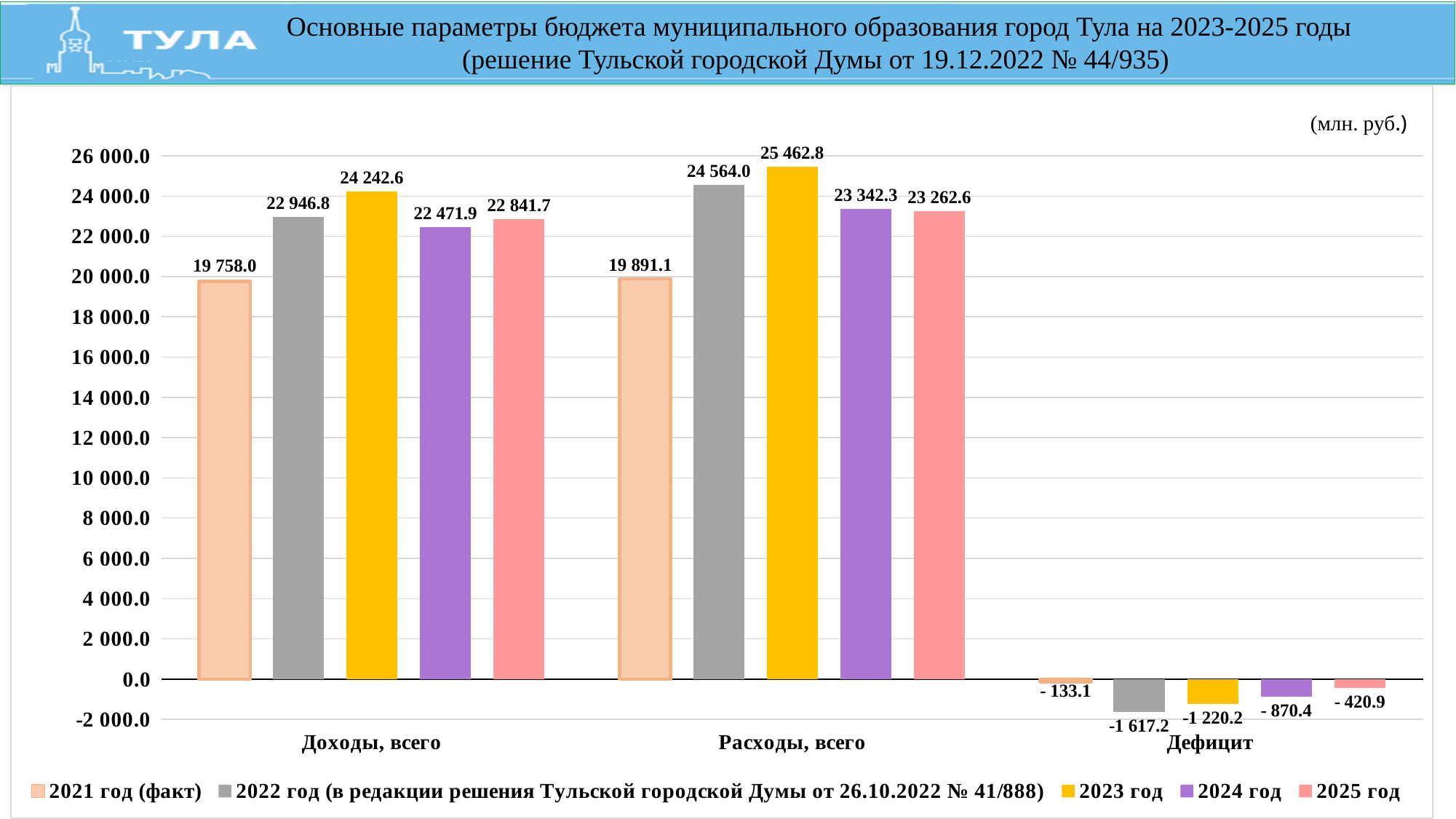
In the Доходы, всего category, which is larger: the value for 2024 год or for 2025 год? 2025 год How many categories are shown on the x axis? 3 What unit of measurement is indicated in the top right corner of the chart? (млн. руб.) What is the difference between Расходы, всего and Доходы, всего for 2023 год? 1 220.2 What kind of chart is shown on the slide? Bar chart What is the value for 2022 год in the Дефицит category? -1 617.2 By how much does Доходы, всего for 2022 год exceed Доходы, всего for 2021 год (факт)? 3 188.8 What is the value for 2023 год in the Доходы, всего category? 24 242.6 Which series has the highest value in the Расходы, всего category? 2023 год How many series does the legend list? 5 Which series has the lowest value in the Доходы, всего category? 2021 год (факт) What is the value for 2025 год in the Расходы, всего category? 23 262.6